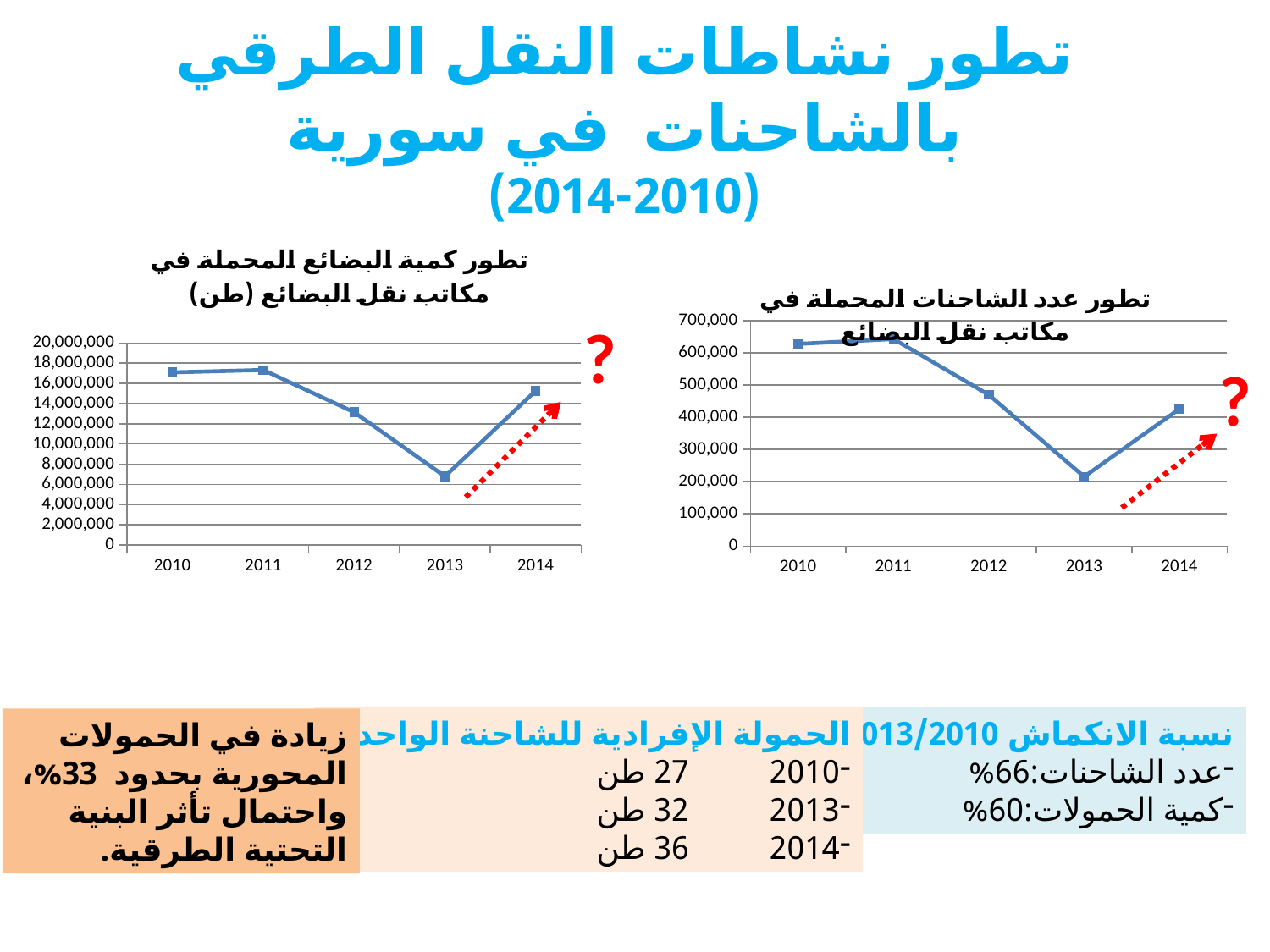
What kind of chart is the right chart (number of loaded trucks)? line chart What kind of chart is the left chart (quantity of goods loaded, in tons)? line chart In the right chart, is the value for 2010 greater or less than 600,000? greater In the left chart, do the values rise or fall from 2011 to 2013? fall How many data points does the right chart show? 5 In the left chart, which year has the lowest quantity of goods loaded? 2013 In the left chart, is the value for 2013 greater or less than 8,000,000? less In the right chart, is the value for 2013 greater or less than 300,000? less How many years are plotted on the left chart? 5 In the right chart, which year has the lowest number of loaded trucks? 2013 In the right chart, which is larger, the value for 2012 or the value for 2014? 2012